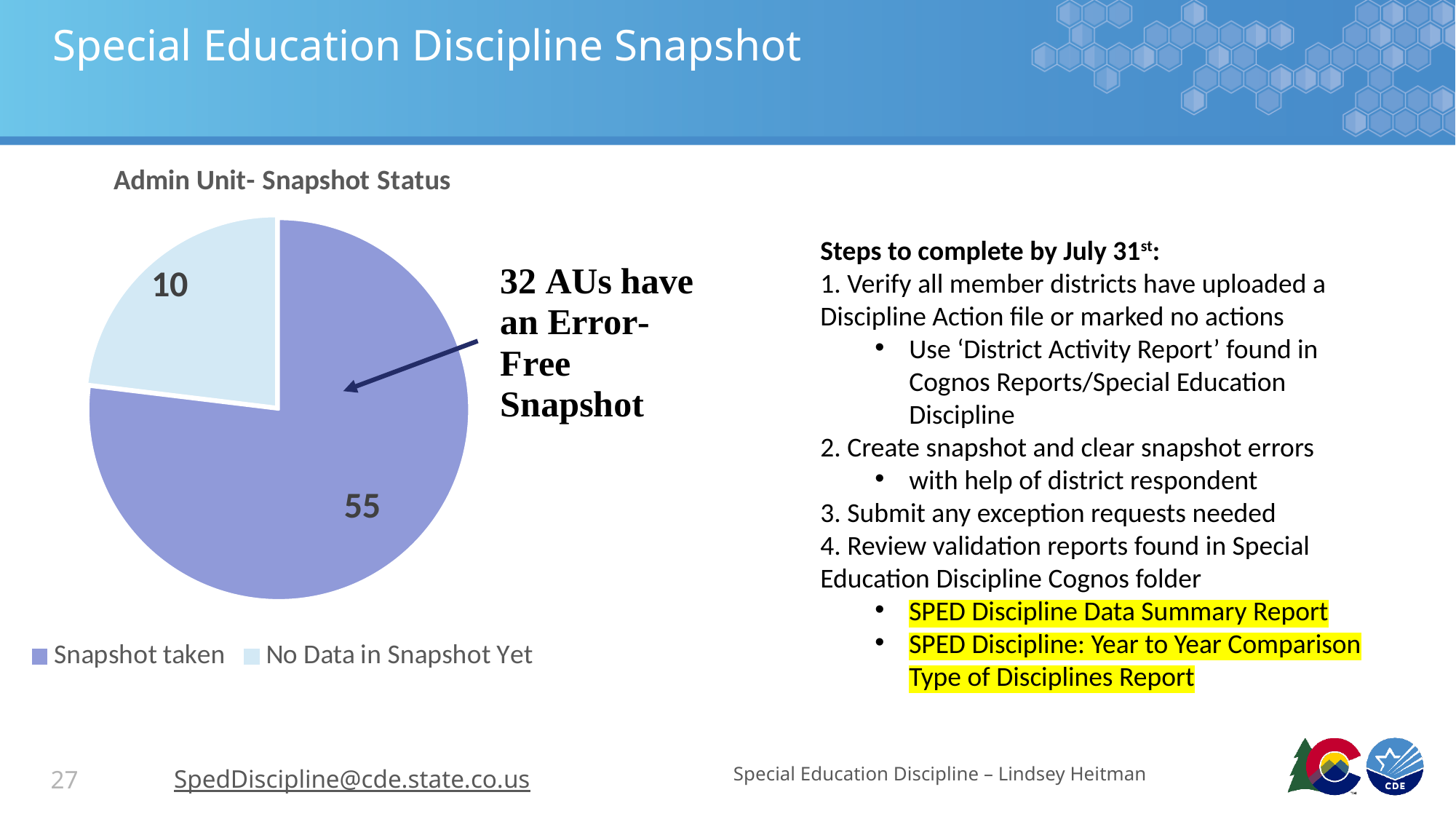
What is the total of the two slices in the pie chart? 65 Which category has the largest slice? Snapshot taken How many slices does the pie chart have? 2 According to the annotation on the chart, how many AUs have an error-free snapshot? 32 AUs What type of chart is shown on the slide? pie chart What is the value for 'Snapshot taken'? 55 Which category has the smallest slice? No Data in Snapshot Yet Which is larger, 'Snapshot taken' or 'No Data in Snapshot Yet'? Snapshot taken What is the difference between the 'Snapshot taken' and 'No Data in Snapshot Yet' values? 45 What is the title of the chart? Admin Unit- Snapshot Status What is the value for 'No Data in Snapshot Yet'? 10 How many categories does the legend list? 2